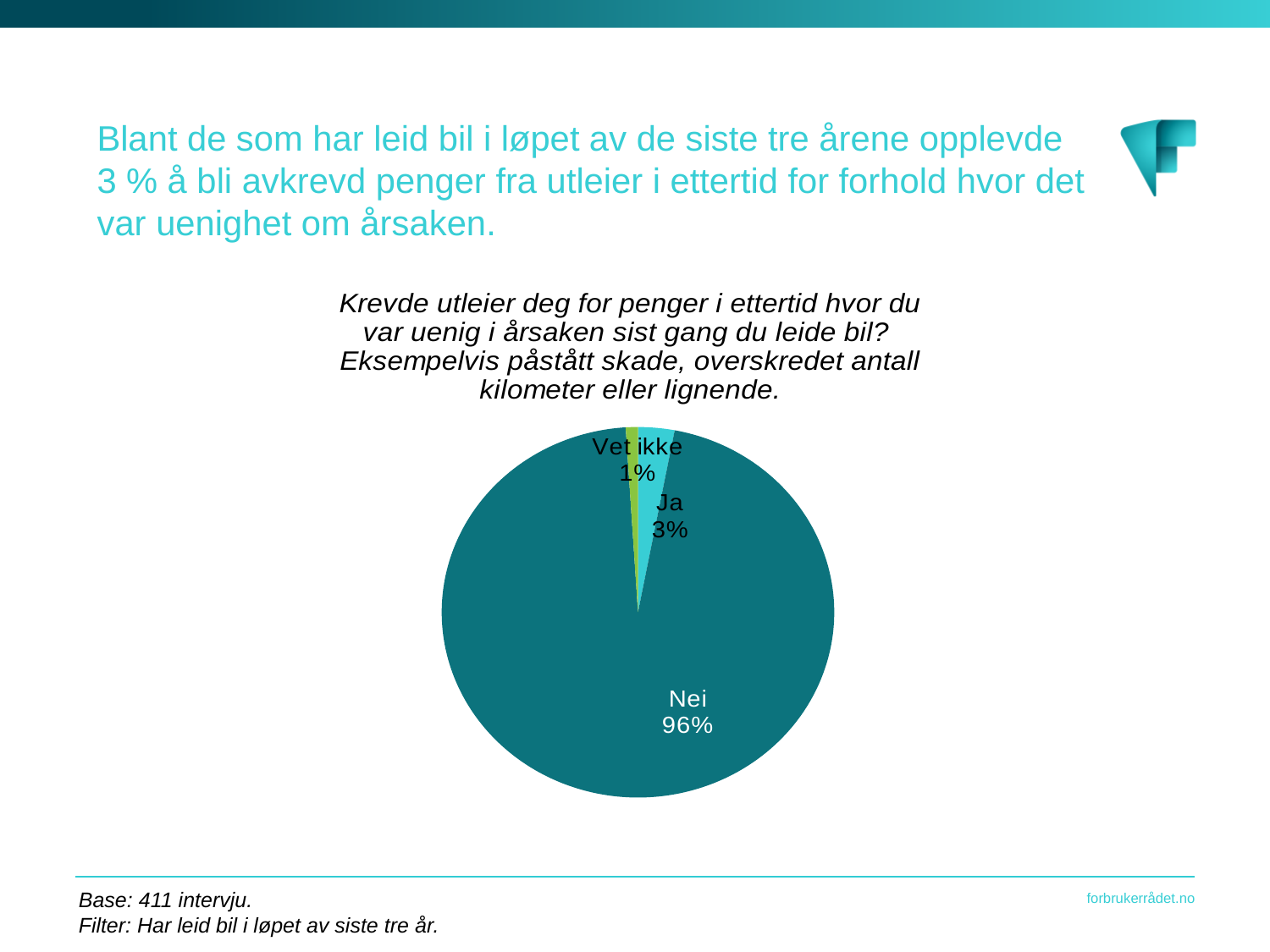
How many slices does the pie chart have? 3 What is the difference in percentage points between "Ja" and "Vet ikke"? 2 What is the difference in percentage points between "Nei" and "Ja"? 93 What is the base (number of interviews) stated for the chart? 411 intervju What percentage of respondents answered "Ja"? 3% What percentage of respondents answered "Nei"? 96% Which category has the smallest share of the pie? Vet ikke What kind of chart is shown on the slide? pie chart What colour is the "Nei" slice of the pie? dark teal Which is larger, the share for "Ja" or the share for "Vet ikke"? Ja What percentage of respondents answered "Vet ikke"? 1% Which category has the largest share of the pie? Nei